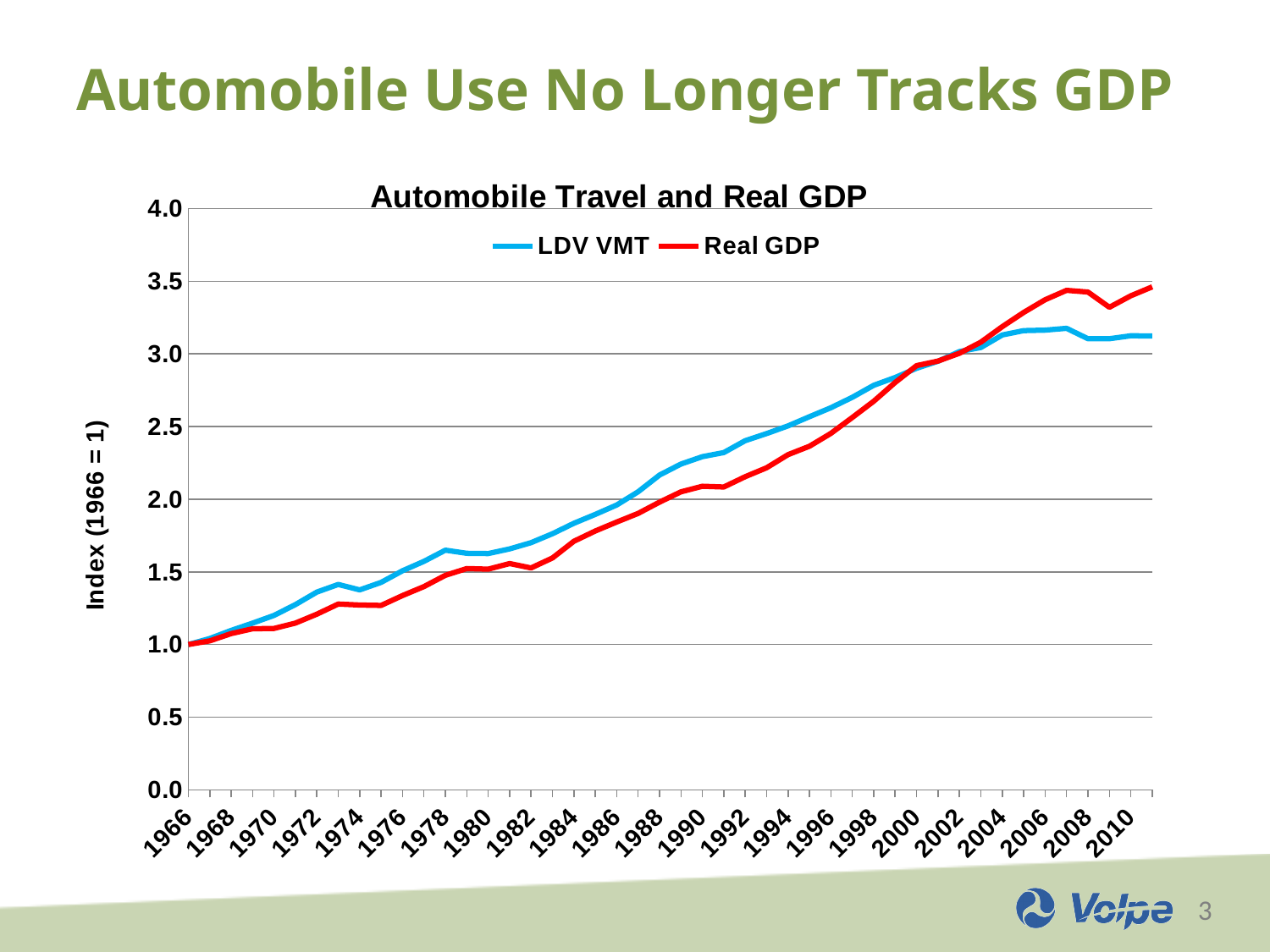
In 2010, which series has the higher value, LDV VMT or Real GDP? Real GDP In 1990, which series has the higher value, LDV VMT or Real GDP? LDV VMT Is the value for LDV VMT in 1980 greater or less than 2.0? less Is the value for Real GDP in 2010 greater or less than 3.0? greater Do the Real GDP values generally rise or fall from 1966 to 2010? rise What kind of chart is shown on the slide? line chart What is the first year shown on the x axis? 1966 Is the value for Real GDP in 1990 greater or less than 2.5? less How many series does the legend list? 2 What is the value of LDV VMT in 1966? 1.0 What is the label on the vertical axis of the chart? Index (1966 = 1) What is the title of the chart? Automobile Travel and Real GDP